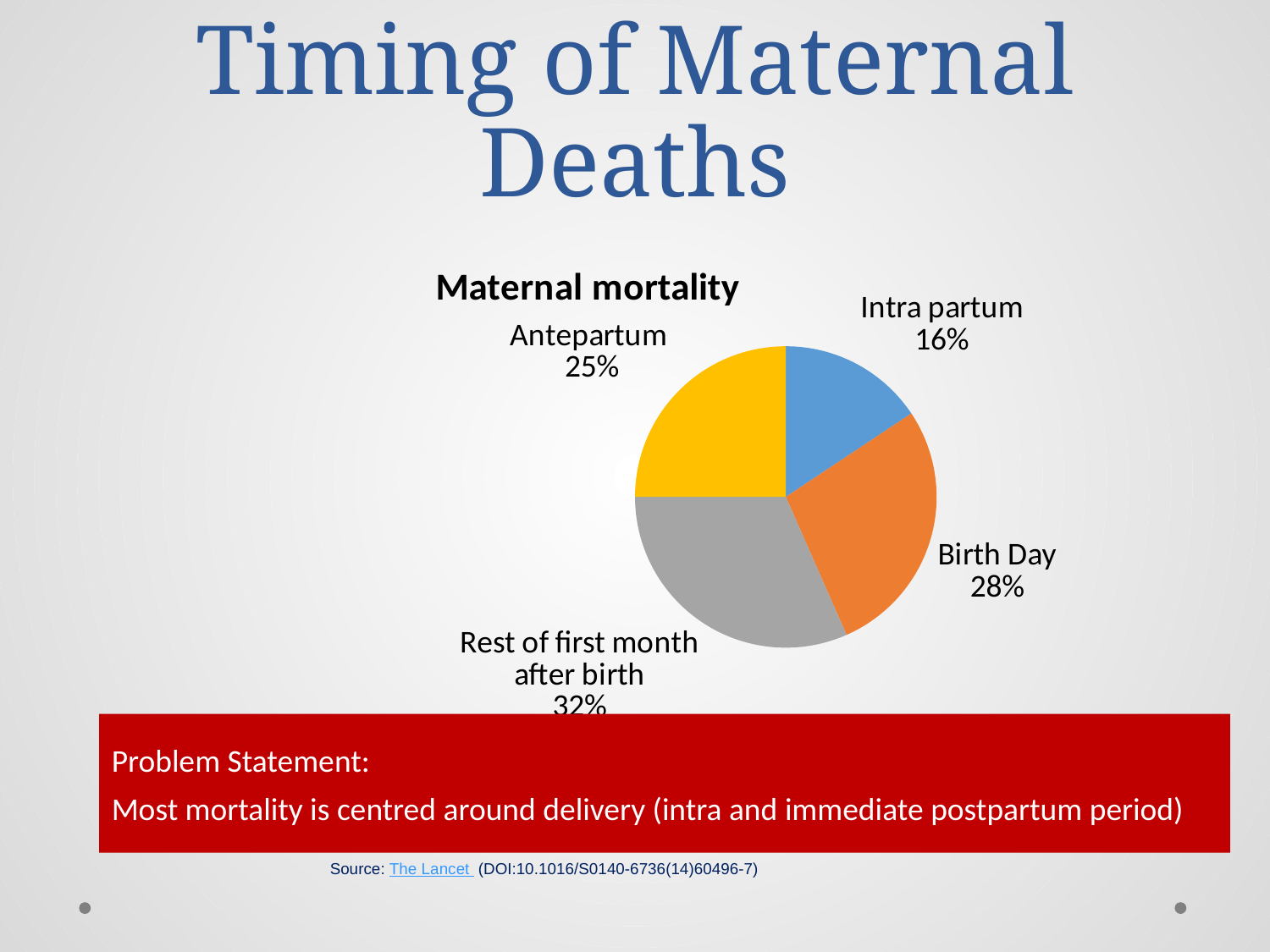
What is the title of the chart? Maternal mortality What percentage of maternal deaths occur intra partum? 16% What kind of chart is shown on the slide? Pie chart Which category accounts for the smallest share of maternal deaths? Intra partum What is the difference in percentage points between Birth Day and Intra partum? 12 What percentage of maternal deaths occur in the rest of the first month after birth? 32% What colour is the Antepartum slice? Yellow Which category accounts for the largest share of maternal deaths? Rest of first month after birth What percentage of maternal deaths occur on the birth day? 28% How many categories does the pie chart show? 4 Which is larger, the Antepartum share or the Birth Day share? Birth Day What percentage of maternal deaths occur antepartum? 25%